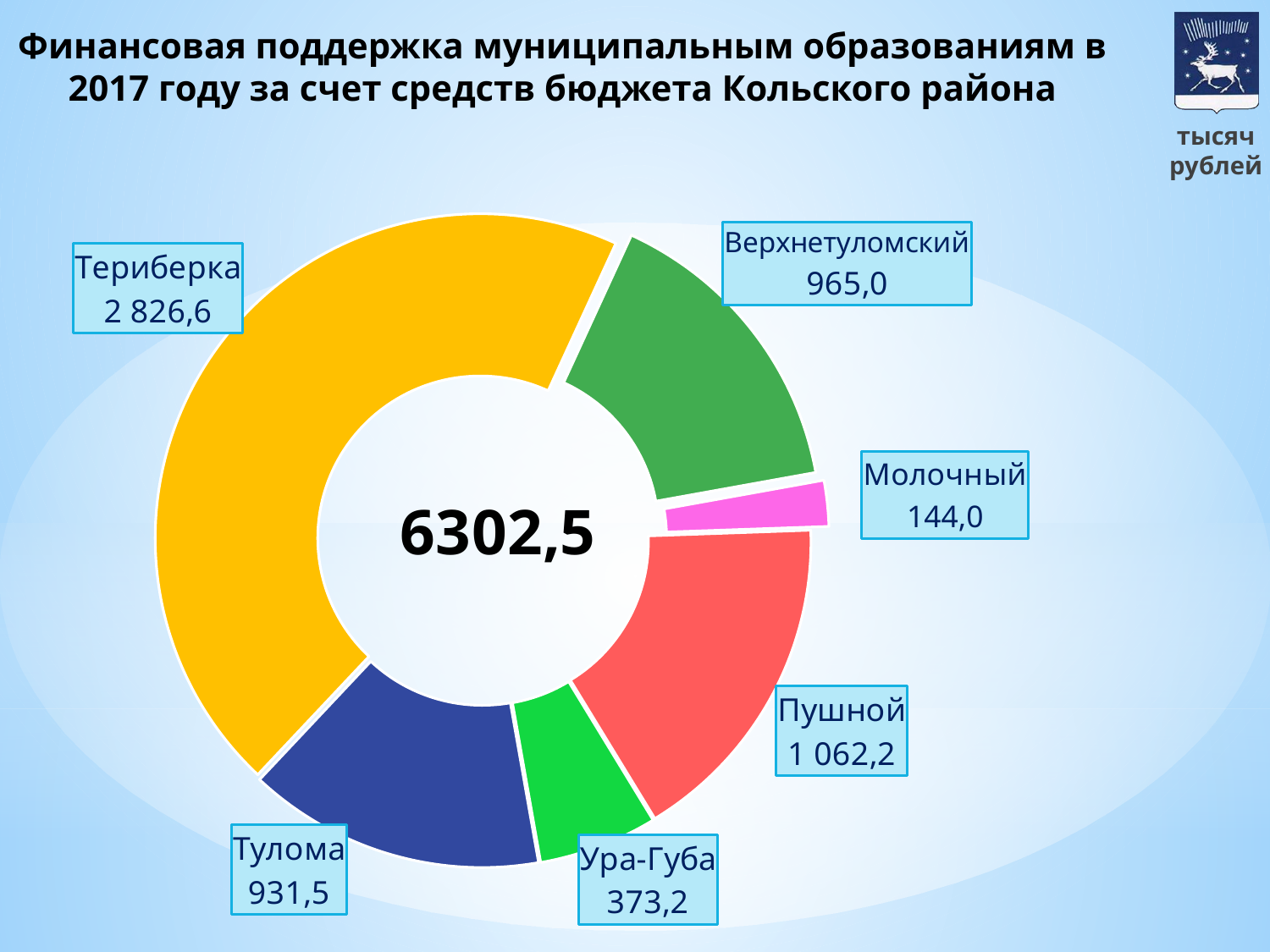
In what units are the values on the chart given? тысяч рублей What is the difference between the values for Пушной and Верхнетуломский? 97,2 Which municipality received the largest amount? Териберка How many municipalities are shown in the chart? 6 What value is shown for Териберка? 2 826,6 Which municipality received the smallest amount? Молочный What value is shown for Молочный? 144,0 Which is larger, the value for Верхнетуломский or the value for Тулома? Верхнетуломский What kind of chart is shown on the slide? doughnut chart What total is shown in the centre of the chart? 6302,5 What value is shown for Пушной? 1 062,2 What value is shown for Ура-Губа? 373,2